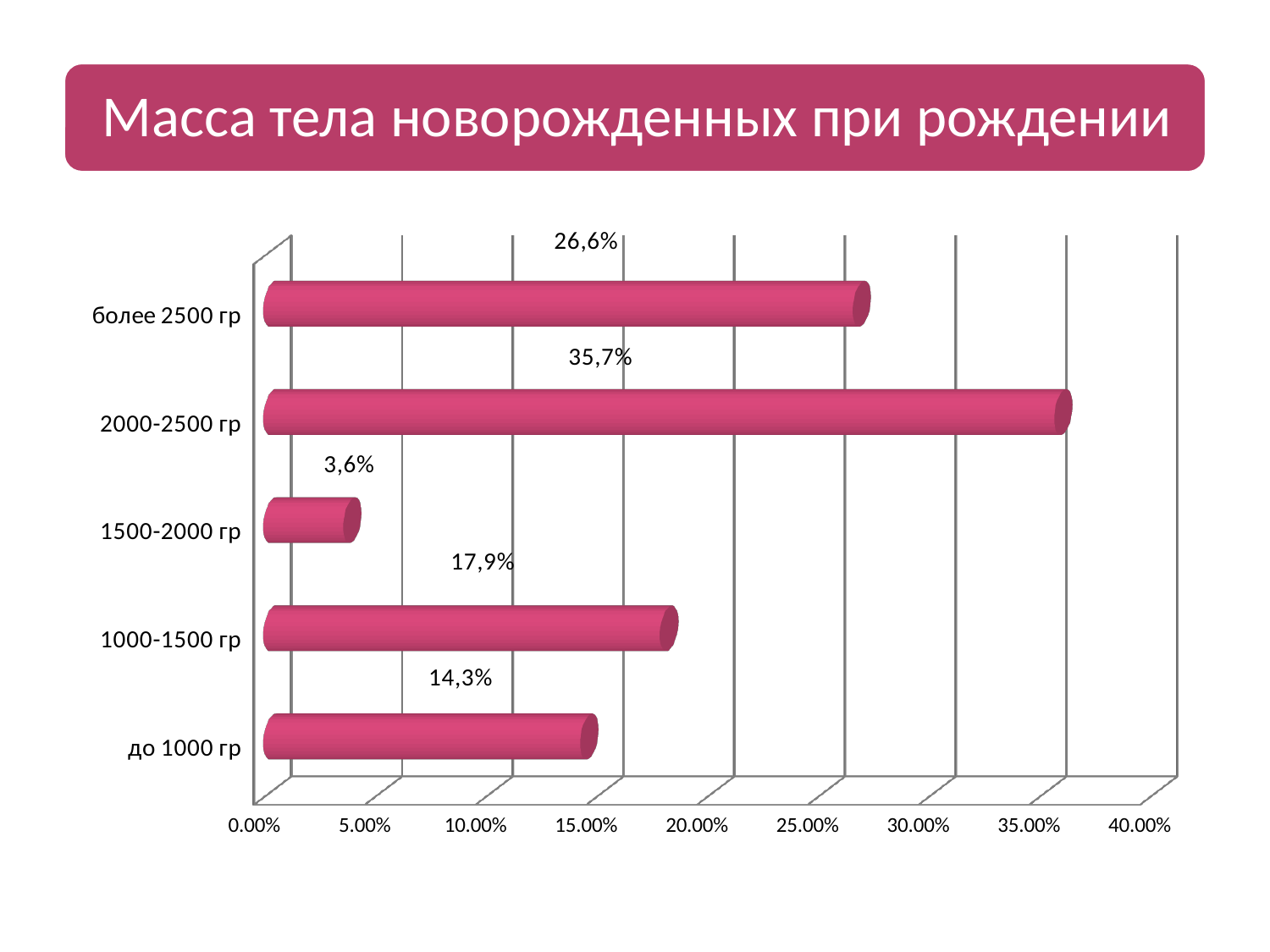
Is the value for "более 2500 гр" greater or less than 25.00%? greater What is the value for the category "более 2500 гр"? 26,6% How many categories are shown in the chart? 5 Which category has the lowest value? 1500-2000 гр What is the value for the category "до 1000 гр"? 14,3% What is the value for the category "1500-2000 гр"? 3,6% Which is larger: the value for "1000-1500 гр" or the value for "до 1000 гр"? 1000-1500 гр What is the difference between the values for "2000-2500 гр" and "более 2500 гр"? 9,1% What kind of chart is shown on the slide? Bar chart What is the difference between the values for "1000-1500 гр" and "до 1000 гр"? 3,6% Which category has the highest value? 2000-2500 гр What is the value for the category "2000-2500 гр"? 35,7%